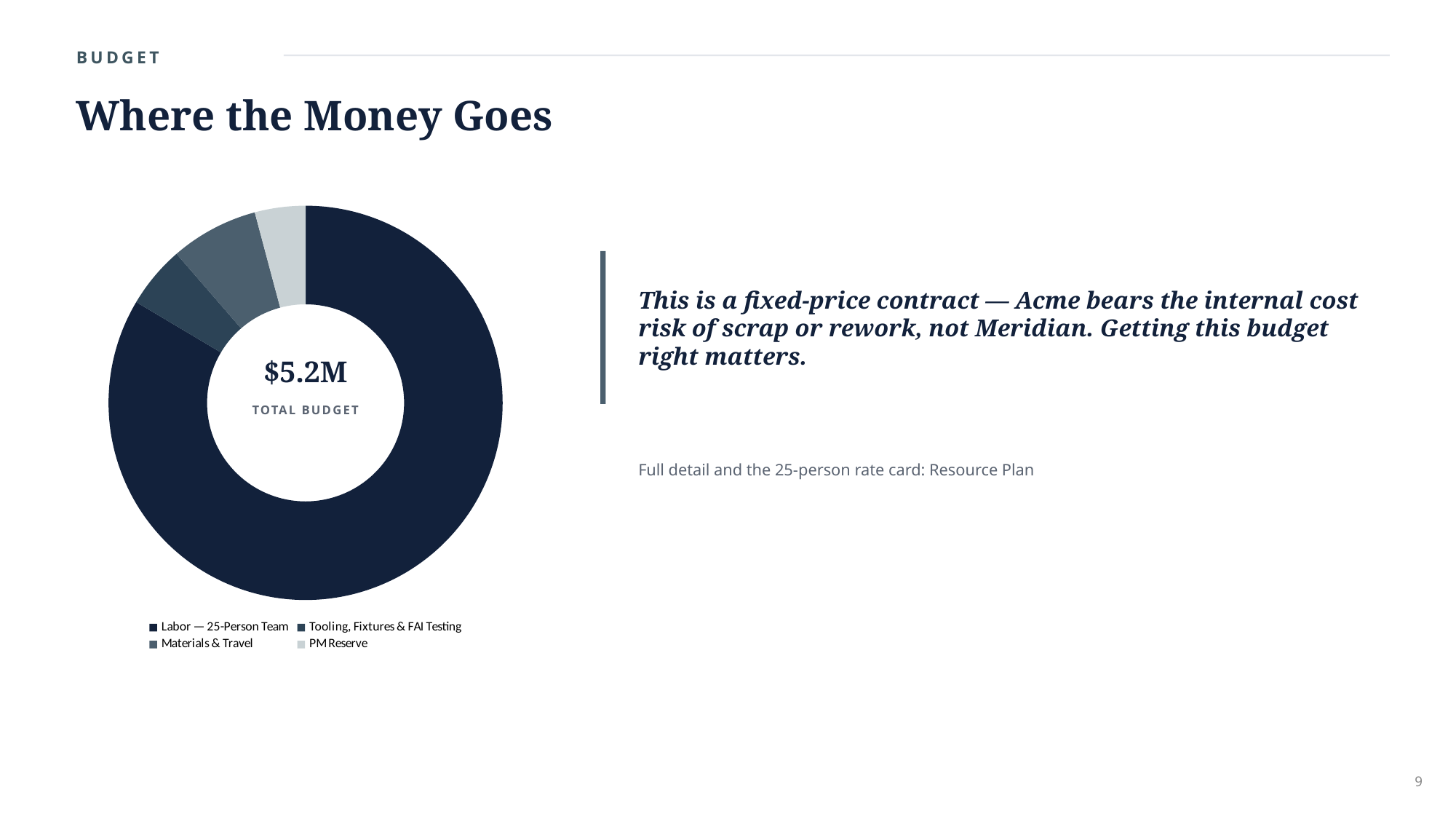
How many entries does the chart legend list? 4 Which legend entry is shown in the lightest grey colour? PM Reserve What kind of chart is shown on the slide? Donut (pie) chart Which is larger: the slice for Tooling, Fixtures & FAI Testing or the slice for PM Reserve? Tooling, Fixtures & FAI Testing How many slices does the donut chart have? 4 Which category takes the largest share of the budget? Labor — 25-Person Team What total budget figure is shown in the centre of the donut chart? $5.2M What is the title of the slide containing the chart? Where the Money Goes Which is larger: the slice for Labor — 25-Person Team or the slice for Tooling, Fixtures & FAI Testing? Labor — 25-Person Team